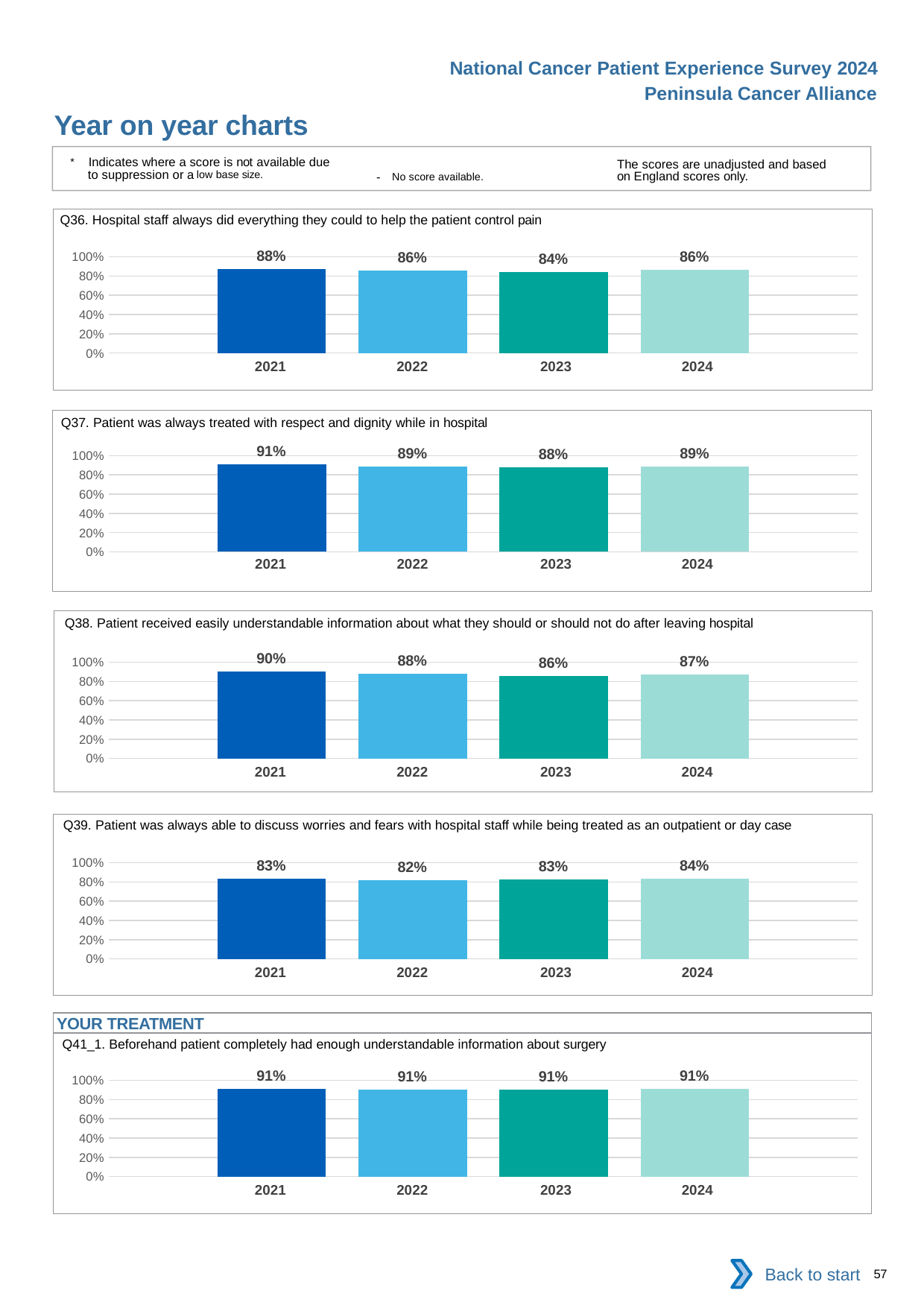
In the Q37 chart, what is the difference between the 2021 and 2023 values? 3% In the Q36 chart, is the value for 2022 greater or less than 80%? greater What type of chart is the Q36 chart? Bar chart In the Q37 chart, which year has the highest value? 2021 In the Q39 chart, which year has the highest value? 2024 In the Q41_1 chart, what is the value for 2023? 91% In the Q36 chart, which year has the lowest value? 2023 In the Q39 chart, what is the value for 2022? 82% In the Q41_1 chart, how many years are plotted? 4 In the Q36 chart, what is the value for 2021? 88% In the Q38 chart, is the value for 2021 larger than the value for 2023? Yes In the Q38 chart, what is the value for 2024? 87%